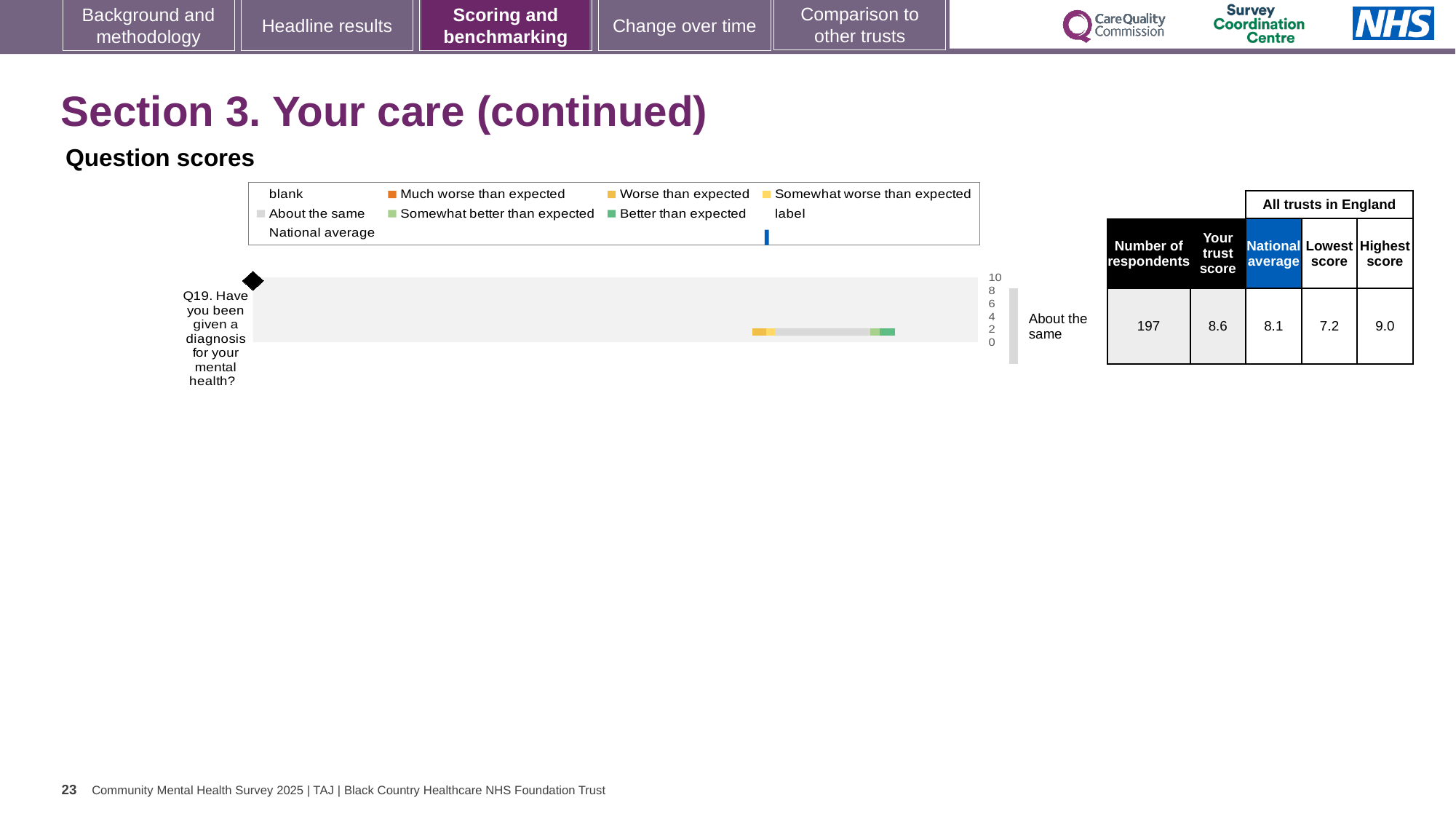
According to the table beside the chart, what is the trust score for Q19? 8.6 According to the table beside the chart, what is the highest score among all trusts in England for Q19? 9.0 For Q19, which is larger: the trust score or the national average? the trust score What benchmark category is shown next to the Q19 bar? About the same According to the table beside the chart, how many respondents answered Q19? 197 What is the difference between the highest score (9.0) and the lowest score (7.2) for Q19 in the table beside the chart? 1.8 What is the maximum value shown on the score axis of the question scores chart? 10 Which question is plotted in the question scores chart? Q19. Have you been given a diagnosis for your mental health? What kind of chart is used to show the Q19 question score? bar chart Which legend entry in the question scores chart is shown with a blue marker? National average According to the table beside the chart, what is the national average for Q19? 8.1 How many questions are plotted in the question scores chart? 1